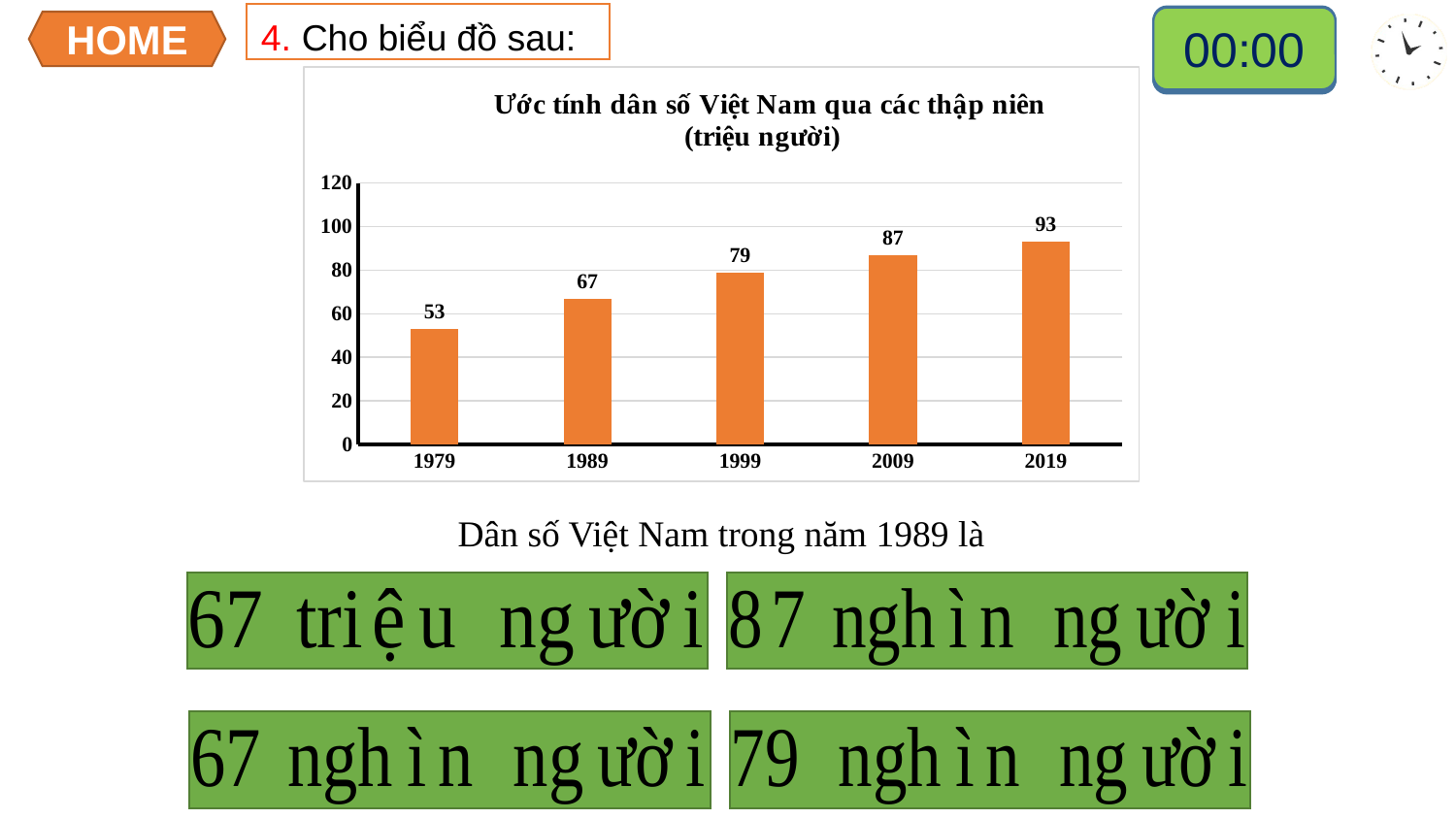
What is the difference between the values for 1999 and 1989? 12 Is the value for 2019 greater or less than 100? less Which year has the lowest estimated population in the chart? 1979 What is the difference between the values for 2019 and 1979? 40 What value is shown for 2009 in the chart? 87 How many years are shown on the x axis of the chart? 5 What value is shown for 1979 in the chart? 53 Which is larger, the value for 1999 or the value for 2009? 2009 Do the values rise or fall from 1979 to 2019? rise Which year has the highest estimated population in the chart? 2019 What kind of chart is shown on the slide? bar chart What is the estimated population of Vietnam in 1989 according to the chart? 67